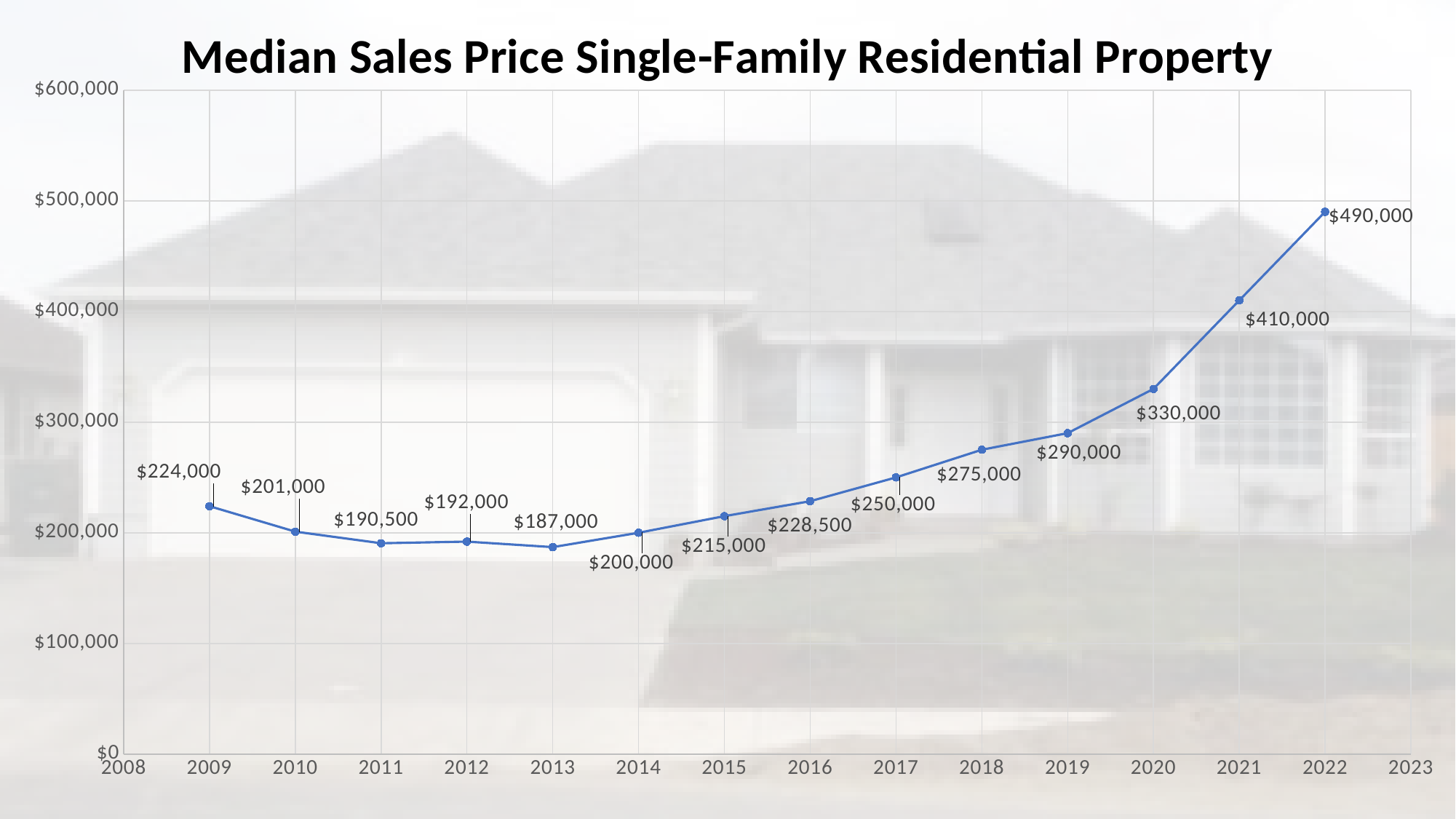
What is the difference between the median sales price in 2009 and in 2010? $23,000 What is the median sales price for 2013? $187,000 What is the median sales price for 2022? $490,000 What kind of chart is shown on the slide? Line chart What is the median sales price for 2016? $228,500 What is the difference between the median sales price in 2022 and in 2021? $80,000 Which year has the highest median sales price? 2022 How many years are plotted on the chart? 14 Is the median sales price for 2020 greater or less than $300,000? greater Which year has a higher median sales price, 2009 or 2014? 2009 What is the title of the chart? Median Sales Price Single-Family Residential Property Which year has the lowest median sales price? 2013